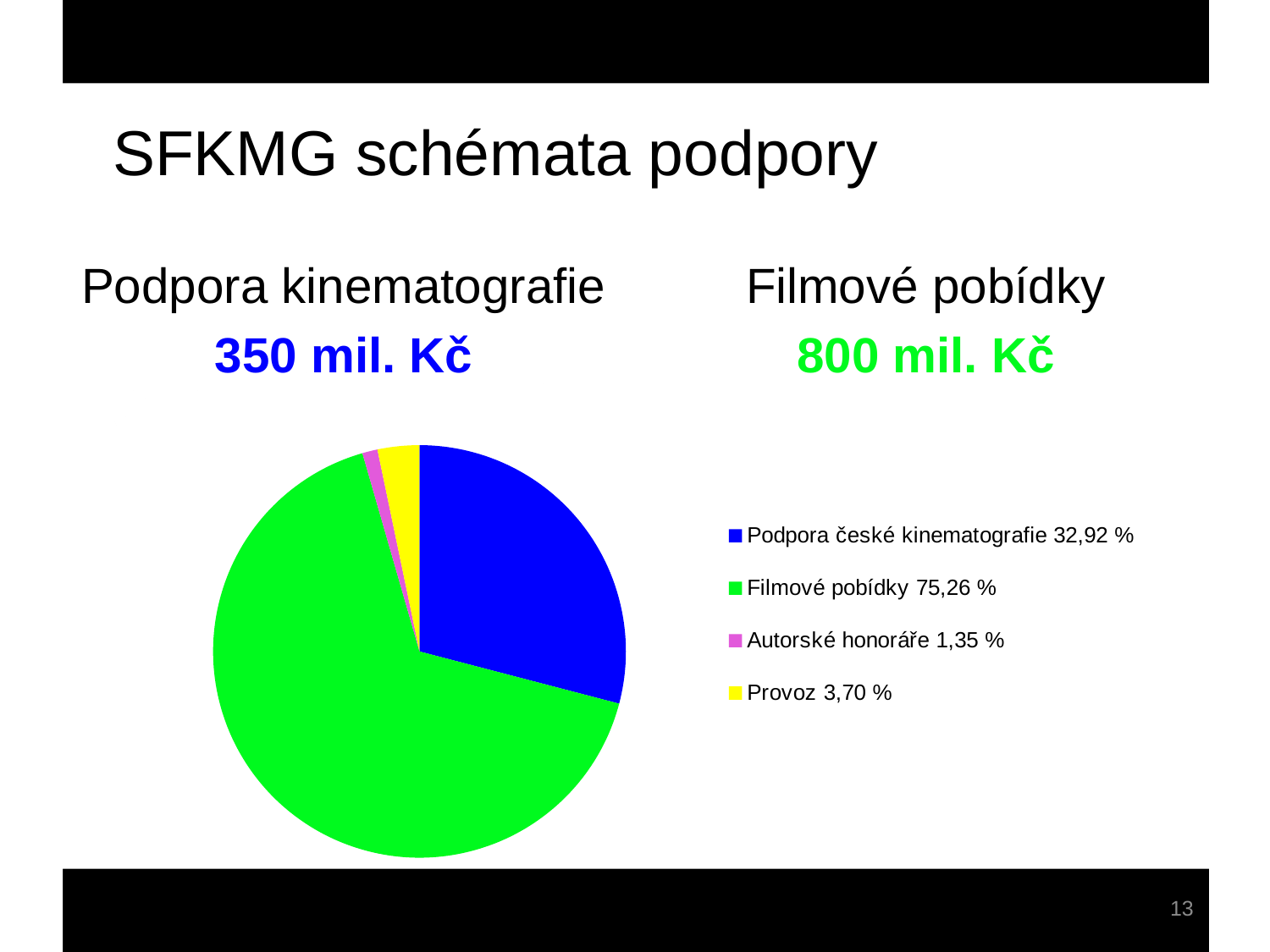
How many slices does the pie chart have? 4 Which category has the largest slice of the pie chart? Filmové pobídky What percentage is shown for Autorské honoráře in the pie chart legend? 1,35 % What percentage is shown for Podpora české kinematografie in the pie chart legend? 32,92 % Which category has the smallest slice of the pie chart? Autorské honoráře Which is larger in the pie chart: Provoz or Autorské honoráře? Provoz What colour is the Filmové pobídky slice in the pie chart? green What colour is the Provoz slice in the pie chart? yellow What is the difference in percentage points between Filmové pobídky and Podpora české kinematografie as printed in the legend? 42,34 What percentage is shown for Provoz in the pie chart legend? 3,70 % What percentage is shown for Filmové pobídky in the pie chart legend? 75,26 % What kind of chart is shown on the slide? pie chart